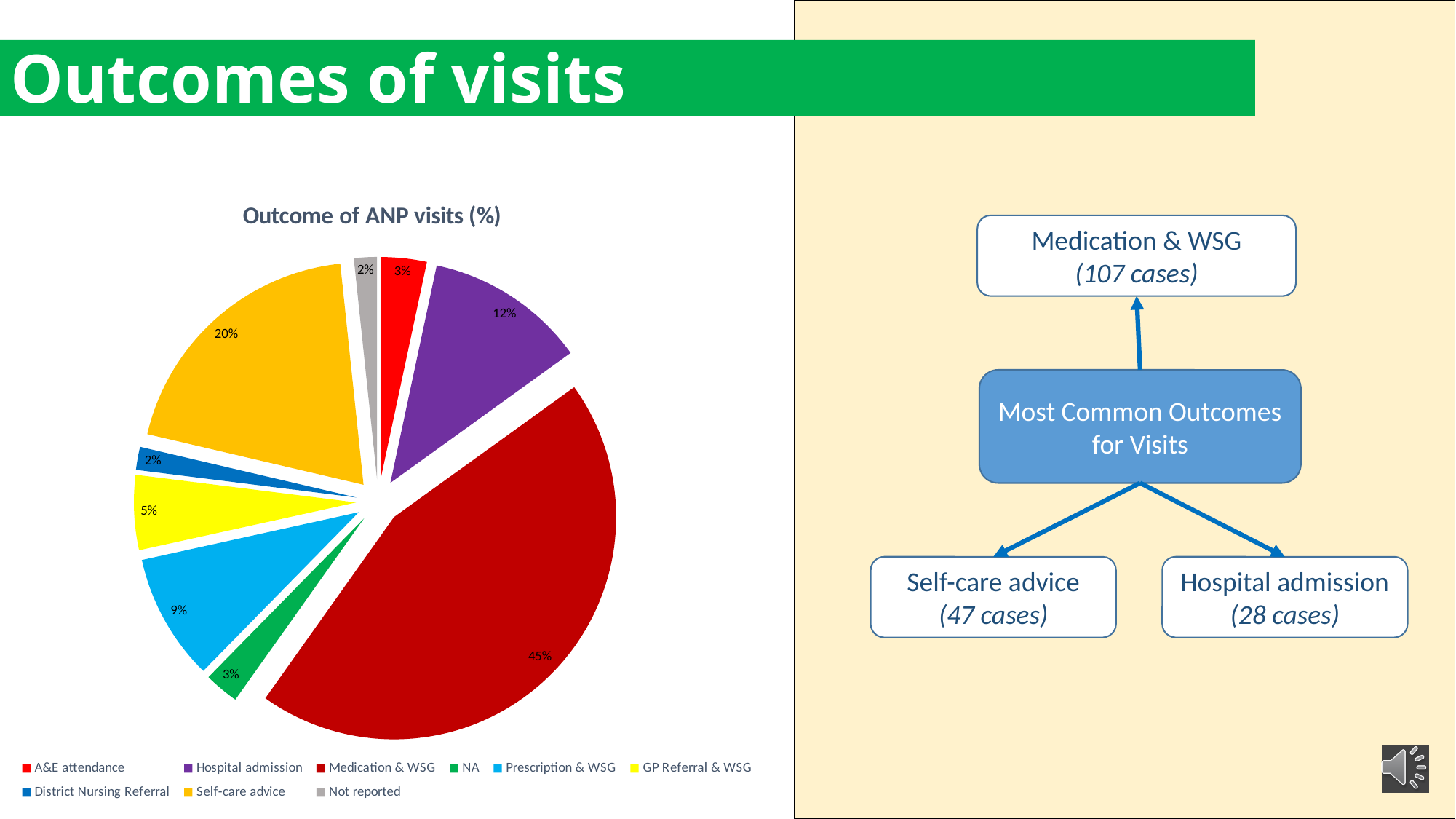
Which outcome has the largest share of ANP visits? Medication & WSG What is the difference in percentage points between Medication & WSG and Self-care advice? 25 What type of chart is shown on the slide? pie chart What colour is the slice for Self-care advice? orange How many outcome categories does the pie chart show? 9 What percentage of ANP visits resulted in Hospital admission? 12% What percentage of ANP visits resulted in Prescription & WSG? 9% What is the title of the chart? Outcome of ANP visits (%) Which has a larger share of ANP visits, Hospital admission or Prescription & WSG? Hospital admission What percentage of ANP visits resulted in GP Referral & WSG? 5% What percentage of ANP visits resulted in Self-care advice? 20% What percentage of ANP visits resulted in Medication & WSG? 45%